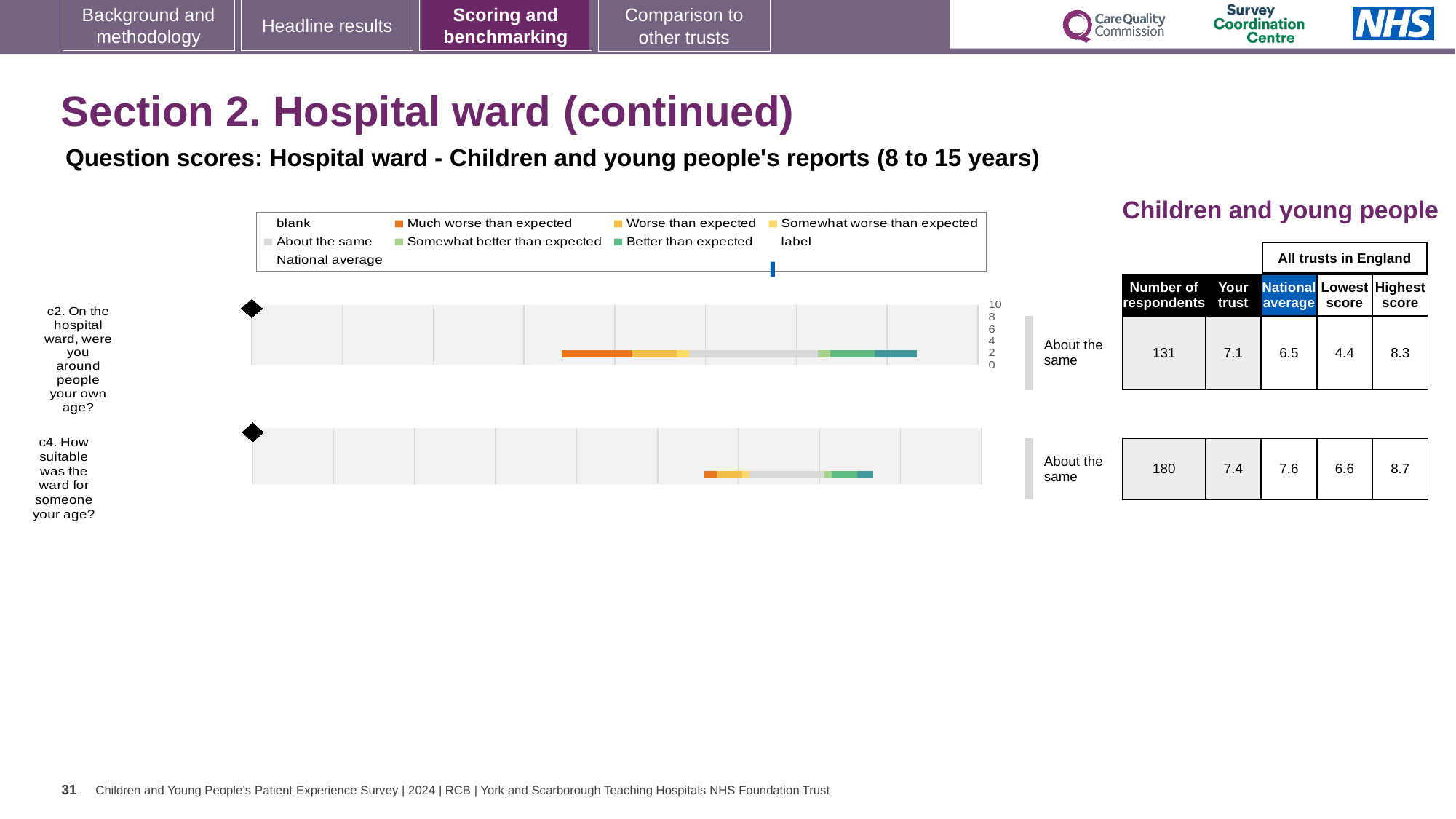
What is the national average score for question c4 (How suitable was the ward for someone your age?)? 7.6 What is the lowest score across all trusts in England for question c2? 4.4 How many respondents answered question c2? 131 What is the difference between the trust's score and the national average for question c2? 0.6 What is the highest score across all trusts in England for question c4? 8.7 What is the 'Your trust' score for question c2 (On the hospital ward, were you around people your own age?)? 7.1 How many questions (categories) are plotted on the slide? 2 Which question has the higher 'Your trust' score, c2 or c4? c4 What benchmark category is shown next to the chart for question c4? About the same What kind of chart is used to show the question scores for c2 and c4? Bar chart For question c4, is the trust's score higher or lower than the national average? Lower What is the difference between the highest and lowest scores for question c2? 3.9